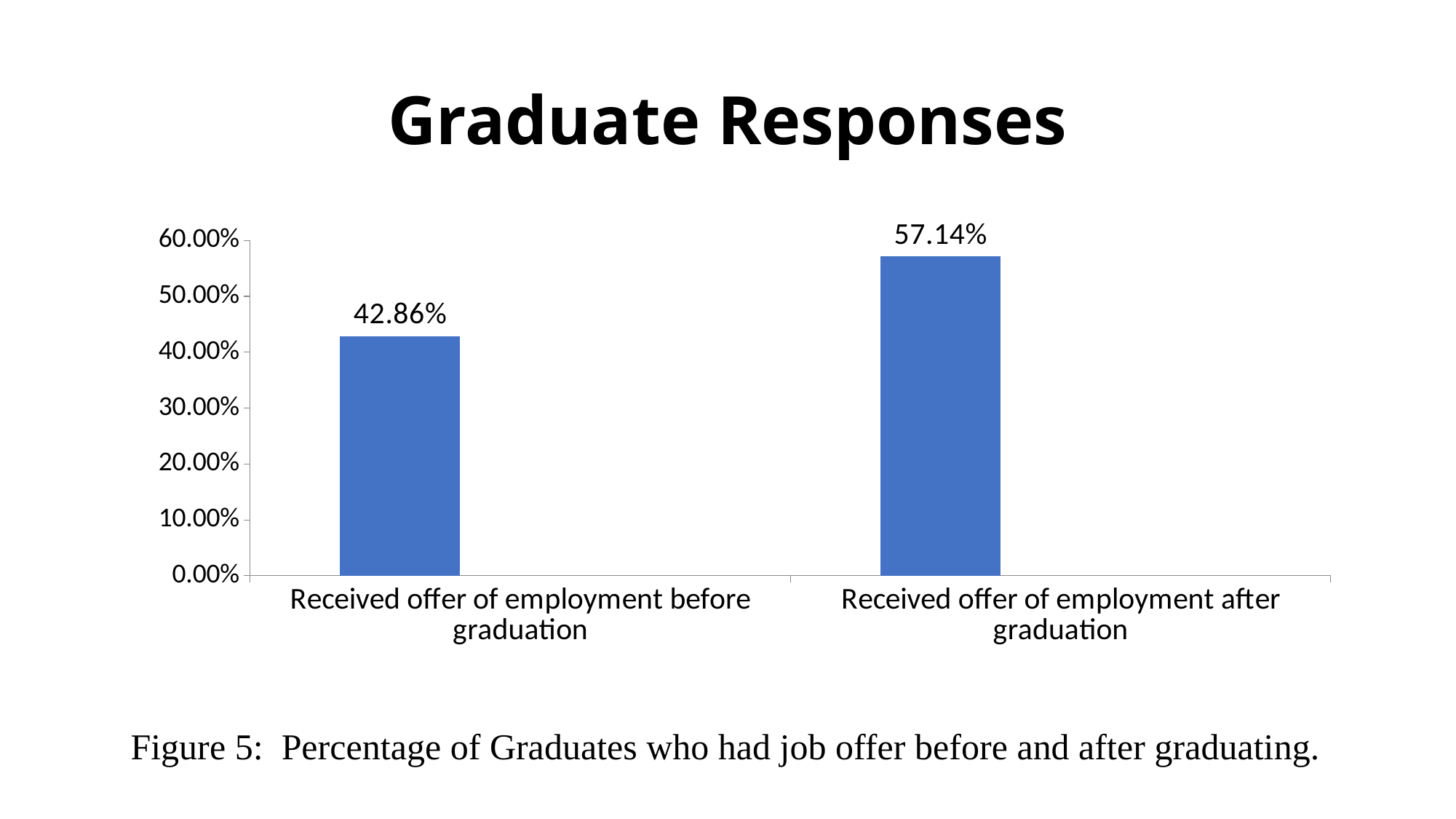
Which category has the higher value? Received offer of employment after graduation Which category has the lower value? Received offer of employment before graduation Is the value for 'Received offer of employment before graduation' greater or less than 50.00%? less What percentage of graduates received an offer of employment after graduation? 57.14% What is the title of the chart? Graduate Responses How many categories are shown in the chart? 2 What percentage of graduates received an offer of employment before graduation? 42.86% Is the value for 'Received offer of employment before graduation' larger or smaller than the value for 'Received offer of employment after graduation'? smaller What is the difference between the percentage who received an offer after graduation and the percentage who received one before graduation? 14.28% What kind of chart is shown on the slide? bar chart What is the highest value shown on the vertical axis? 60.00% Is the value for 'Received offer of employment after graduation' greater or less than 50.00%? greater